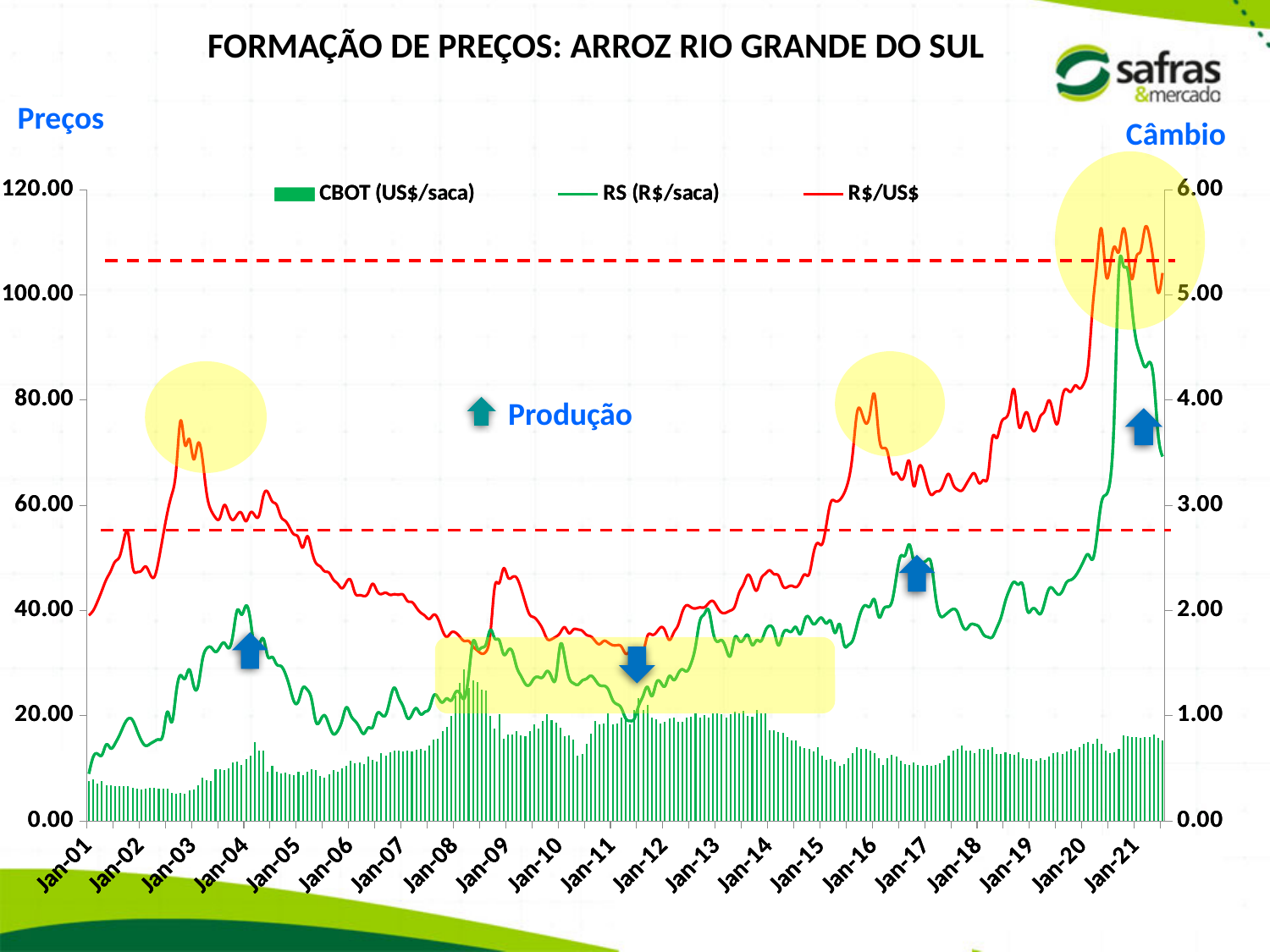
At Jan-16, which is higher: the RS (R$/saca) line or the CBOT (US$/saca) bar? RS (R$/saca) What is the title of the chart? FORMAÇÃO DE PREÇOS: ARROZ RIO GRANDE DO SUL Is the RS (R$/saca) value at Jan-01 greater or less than 20.00? less Does the R$/US$ line rise or fall between Jan-05 and Jan-08? fall How many year labels are shown on the x axis? 21 How many series does the legend list? 3 Is the R$/US$ value at Jan-16 greater or less than 3.00? greater Is the R$/US$ value at Jan-01 greater or less than 3.00? less What kind of chart is this? Combined bar and line chart In which year does the RS (R$/saca) line reach its highest value? 2020 Which series is plotted as bars? CBOT (US$/saca)